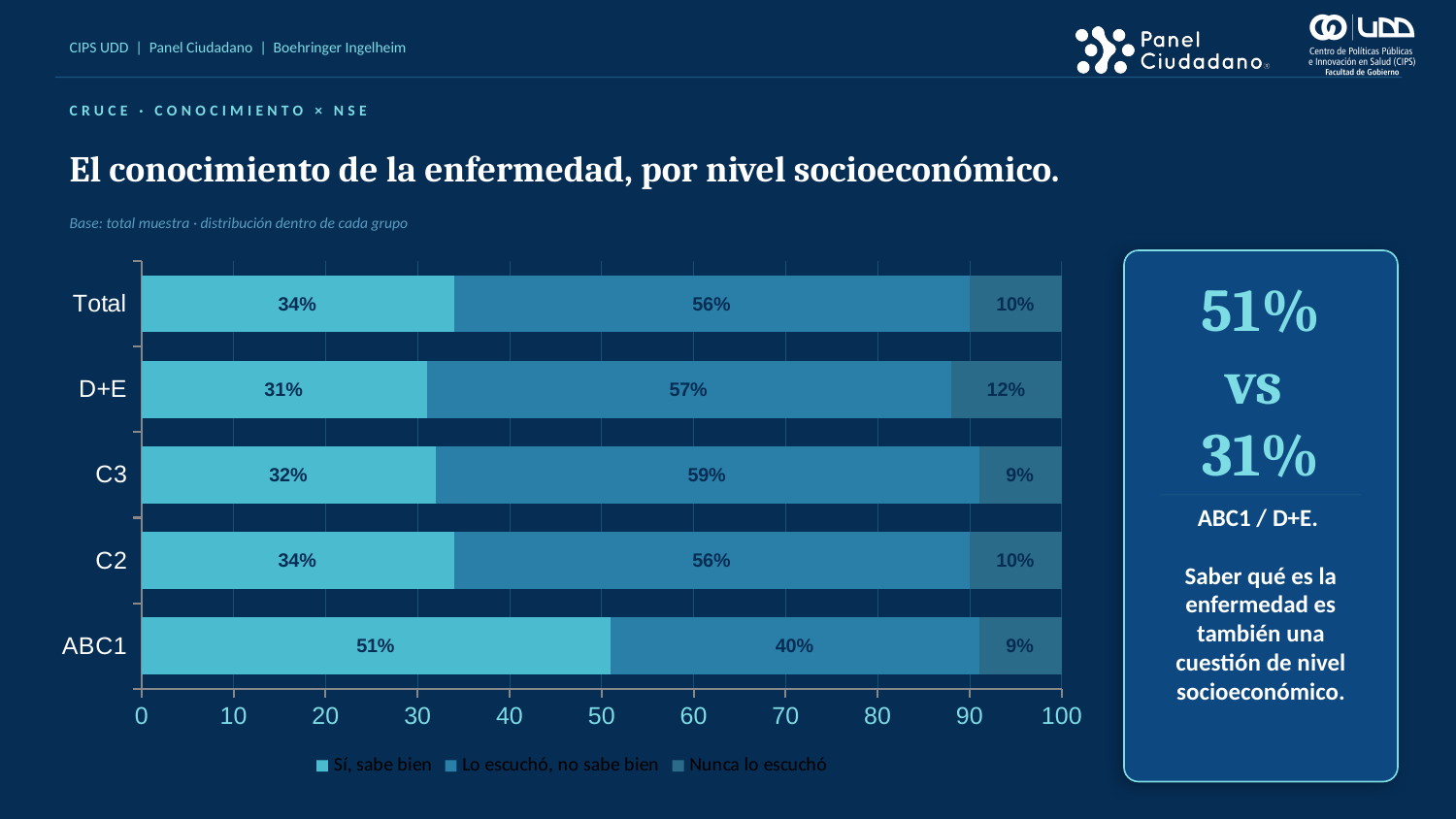
Which group has the highest share of "Sí, sabe bien"? ABC1 What percentage of the D+E group answered "Nunca lo escuchó"? 12% What is the total of the stacked bar for the C2 group? 100% What is the title of the chart? El conocimiento de la enfermedad, por nivel socioeconómico. What kind of chart is shown on the slide? Stacked bar chart What is the value for "Lo escuchó, no sabe bien" in the C3 group? 59% How many series does the legend list? 3 What percentage of the ABC1 group answered "Sí, sabe bien"? 51% Which is larger: "Lo escuchó, no sabe bien" for C3 or for ABC1? C3 How many groups (categories) are shown on the y axis? 5 What is the difference in "Sí, sabe bien" between ABC1 and D+E? 20% Which group has the lowest share of "Sí, sabe bien"? D+E